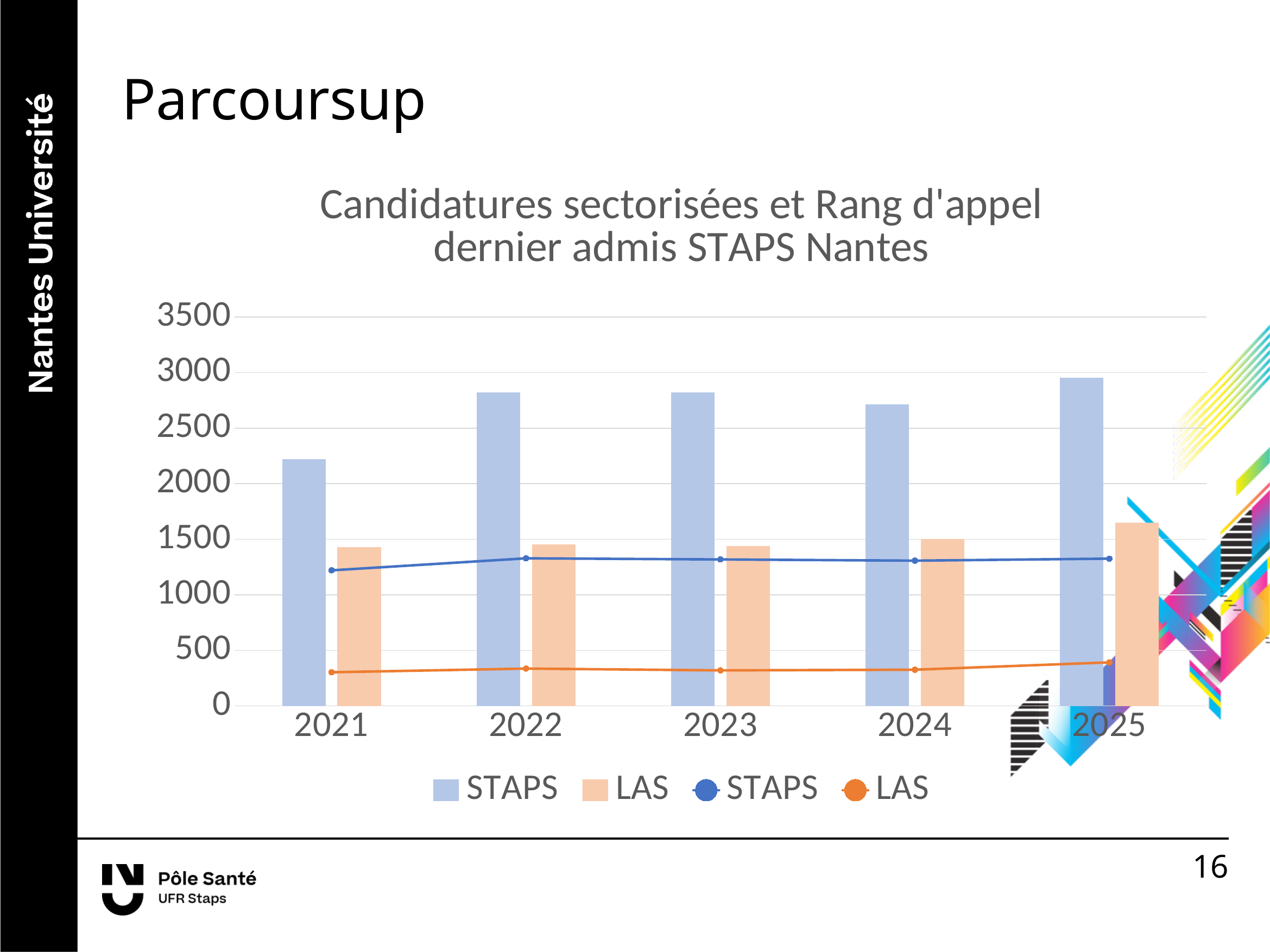
How many years are shown on the x axis of the chart? 5 In which year is the STAPS bar the lowest? 2021 Which is larger in 2024, the STAPS bar or the LAS bar? STAPS In which year is the STAPS bar the highest? 2025 How many series does the chart legend list? 4 In which year is the LAS bar the highest? 2025 Is the STAPS bar for 2025 greater or less than 3000? less What is the title of the chart? Candidatures sectorisées et Rang d'appel dernier admis STAPS Nantes Is the LAS line value for 2021 greater or less than 500? less Is the LAS bar for 2025 greater or less than 1500? greater What kind of chart is shown on the slide? A combined bar and line chart